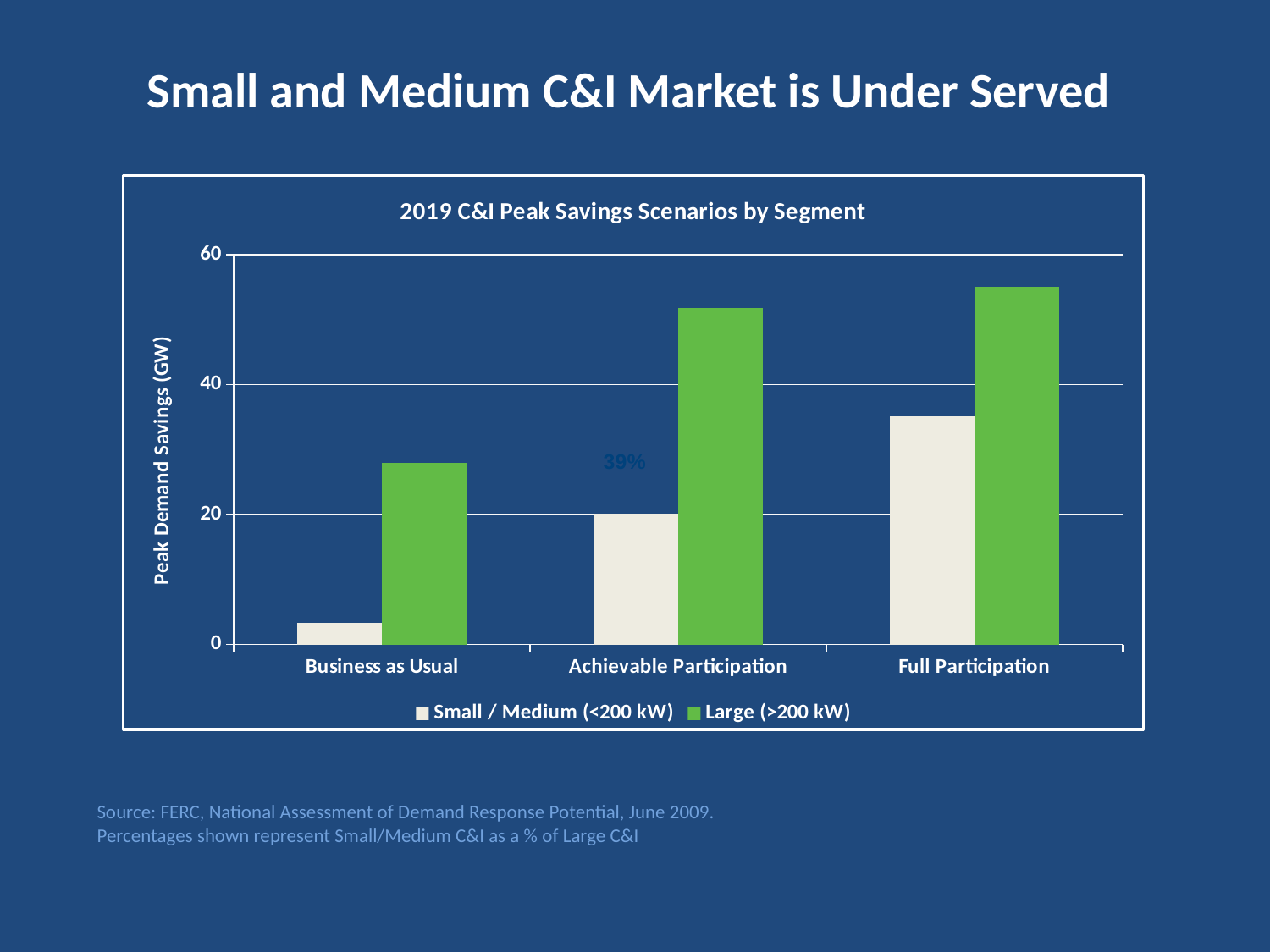
Is the Large (>200 kW) value for Business as Usual greater or less than 20? greater How many scenario categories are shown on the x axis? 3 How many series does the legend list? 2 Which bar is the tallest in the chart? Large (>200 kW) in Full Participation Do the Small / Medium (<200 kW) values rise or fall from Business as Usual to Full Participation? rise Is the Small / Medium (<200 kW) value for Full Participation greater or less than 40? less Is the Large (>200 kW) value for Achievable Participation greater or less than 40? greater In the Full Participation scenario, which series has the larger value, Small / Medium (<200 kW) or Large (>200 kW)? Large (>200 kW) What kind of chart is shown on the slide? Bar chart What is the label of the y axis? Peak Demand Savings (GW) What is the title of the chart? 2019 C&I Peak Savings Scenarios by Segment Which bar is the shortest in the chart? Small / Medium (<200 kW) in Business as Usual